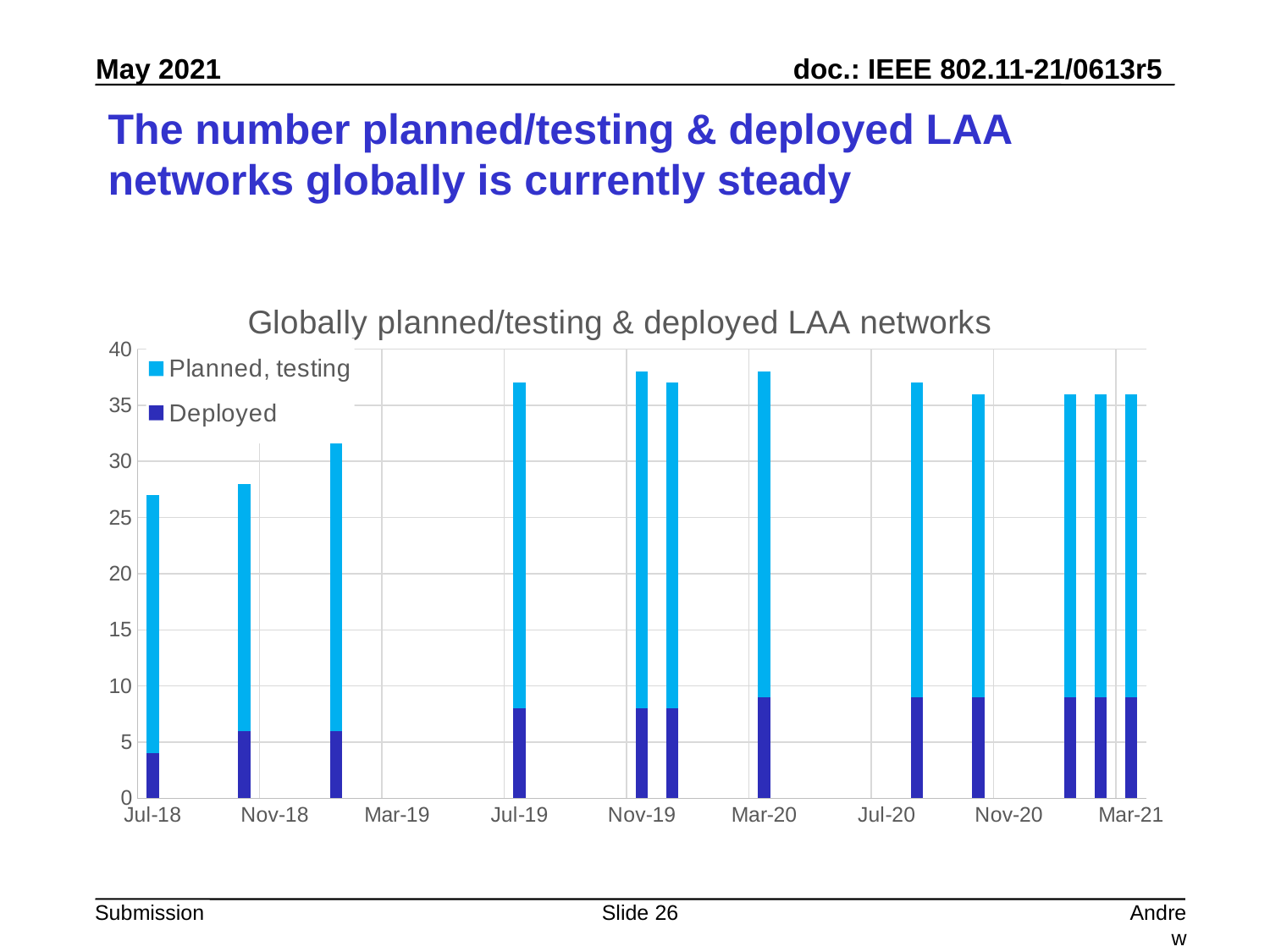
What is the title of the chart? Globally planned/testing & deployed LAA networks Is the Deployed value at Mar-21 greater or less than 10? less Do the total bar heights rise or fall from Jul-18 to Jul-19? rise Is the total height of the bar at Mar-20 greater or less than 35? greater Is the total height of the bar at Jul-19 greater or less than 35? greater What are the two series named in the chart legend? Planned, testing; Deployed How many bars are plotted in the chart? 12 Which bar is taller in total, Jul-18 or Jul-19? Jul-19 How many series does the chart legend list? 2 What kind of chart is shown on the slide? Stacked bar chart